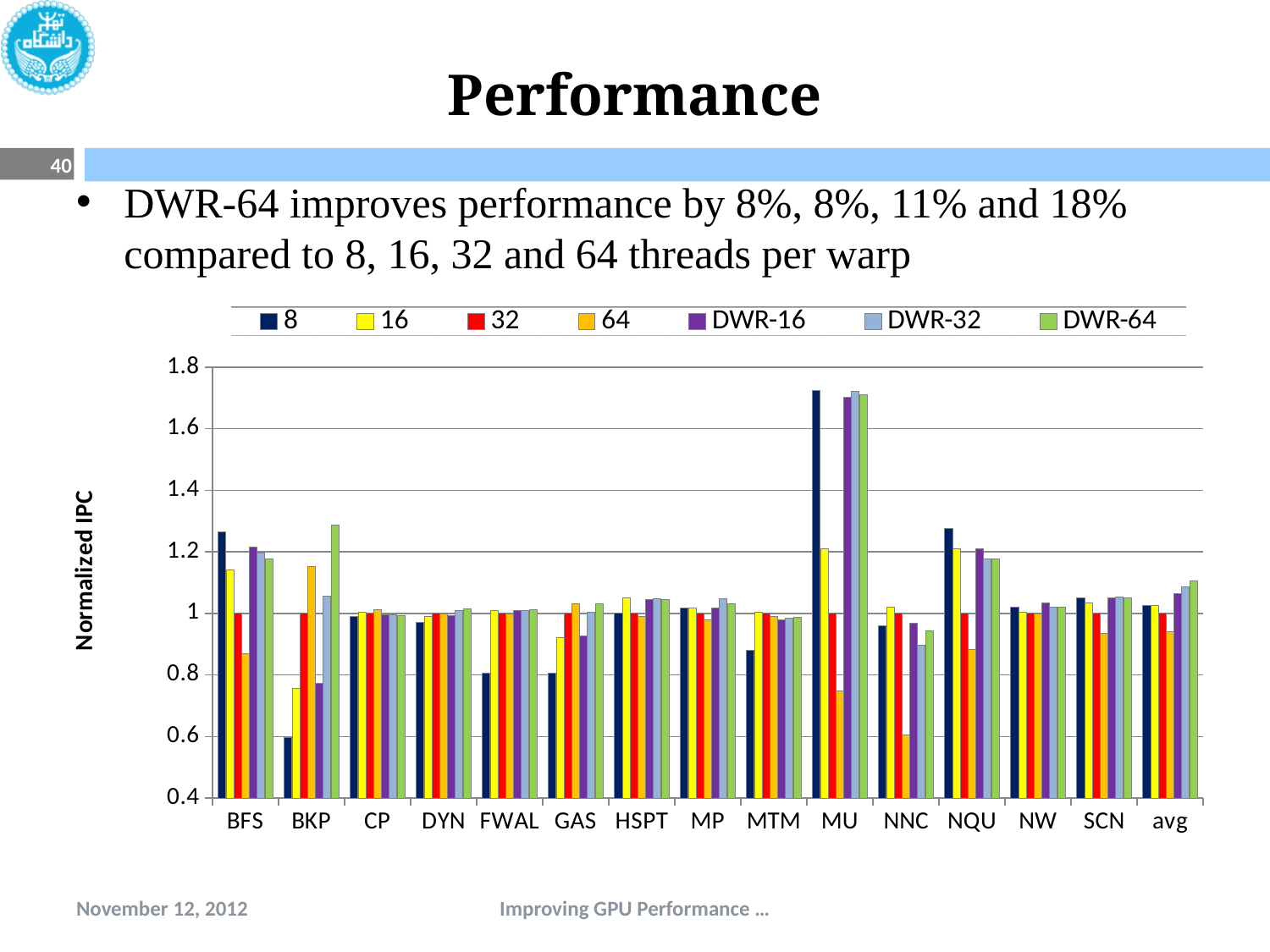
Is the value for MU in the series 8 greater or less than 1.6? greater How many series does the legend list? 7 For BKP, which is larger: the value for series 8 or the value for series DWR-64? DWR-64 For MU, which is larger: the value for series 8 or the value for series 64? 8 For the series 8, which category has the lowest value? BKP For the series 8, which category has the highest value? MU Is the value for MU in the series 64 greater or less than 0.8? less Is the value for BKP in the series DWR-64 greater or less than 1.2? greater How many categories are shown along the x axis? 15 Which series is listed last in the legend? DWR-64 What is the label of the y axis? Normalized IPC What kind of chart is shown on the slide? bar chart